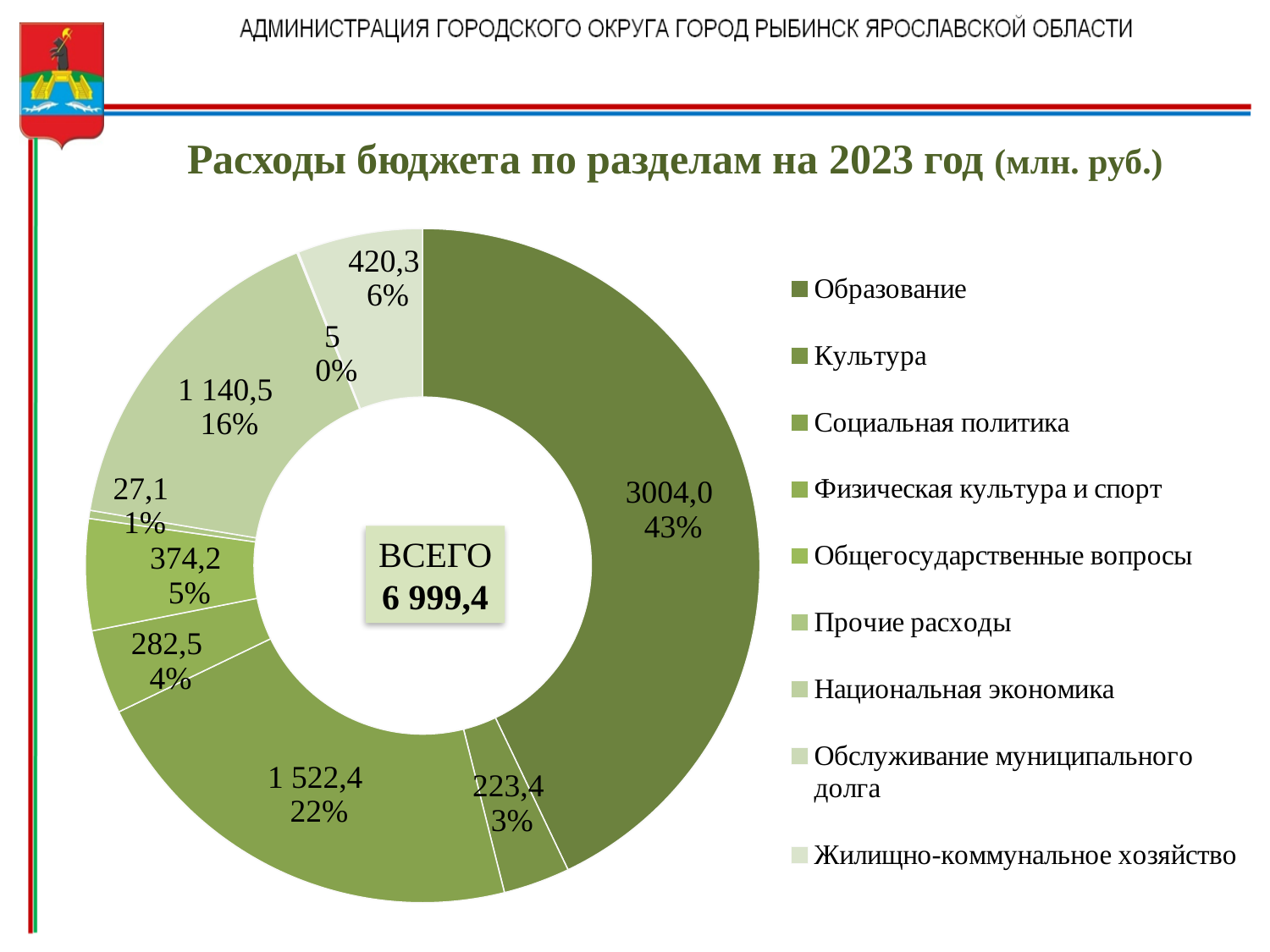
What is the title of the chart? Расходы бюджета по разделам на 2023 год (млн. руб.) What total (ВСЕГО) is shown in the centre of the chart? 6 999,4 What is the value for Жилищно-коммунальное хозяйство? 420,3 What type of chart is shown on the slide? doughnut (pie) chart Which category has the smallest value? Обслуживание муниципального долга How many categories does the legend list? 9 What is the value for Национальная экономика? 1 140,5 What share of the total does Социальная политика account for? 22% What is the difference between the values for Общегосударственные вопросы and Физическая культура и спорт? 91,7 What is the value for Образование? 3004,0 Which category has the largest share of the budget expenditures? Образование Which is larger, the value for Культура or the value for Прочие расходы? Культура